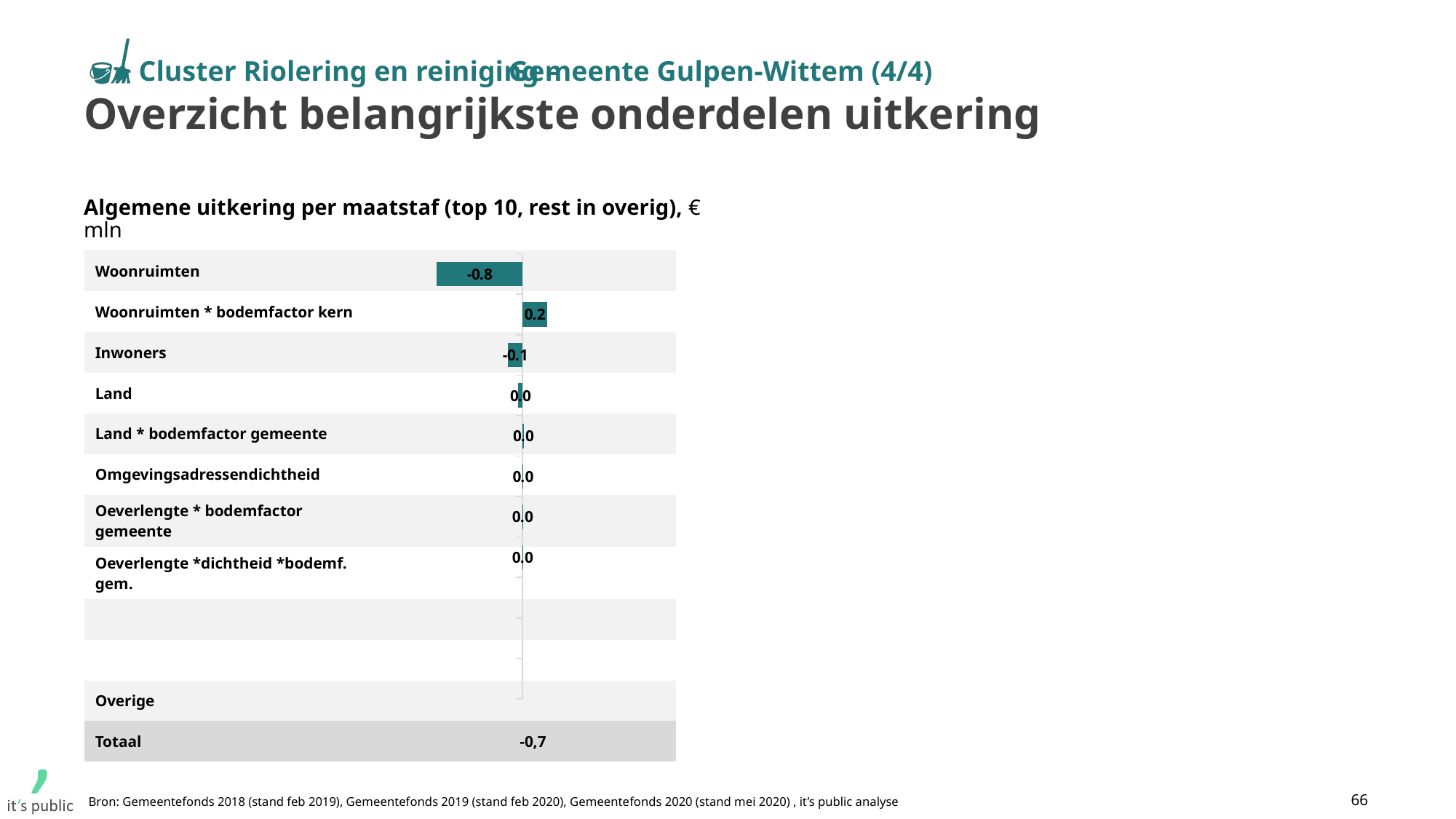
Which category has the lowest (most negative) value? Woonruimten What is the value for Inwoners? -0.1 What is the value for Woonruimten * bodemfactor kern? 0.2 Which category has the highest value? Woonruimten * bodemfactor kern What kind of chart is shown on the slide? Bar chart What is the difference between the values for Woonruimten * bodemfactor kern and Woonruimten? 1.0 How many categories have a data label printed in the chart (excluding Overige and Totaal)? 8 What is the value shown for Totaal? -0,7 What is the value for Land * bodemfactor gemeente? 0.0 Which is larger, the value for Inwoners or the value for Woonruimten * bodemfactor kern? Woonruimten * bodemfactor kern What is the value for Woonruimten? -0.8 What unit is stated in the chart title? € mln